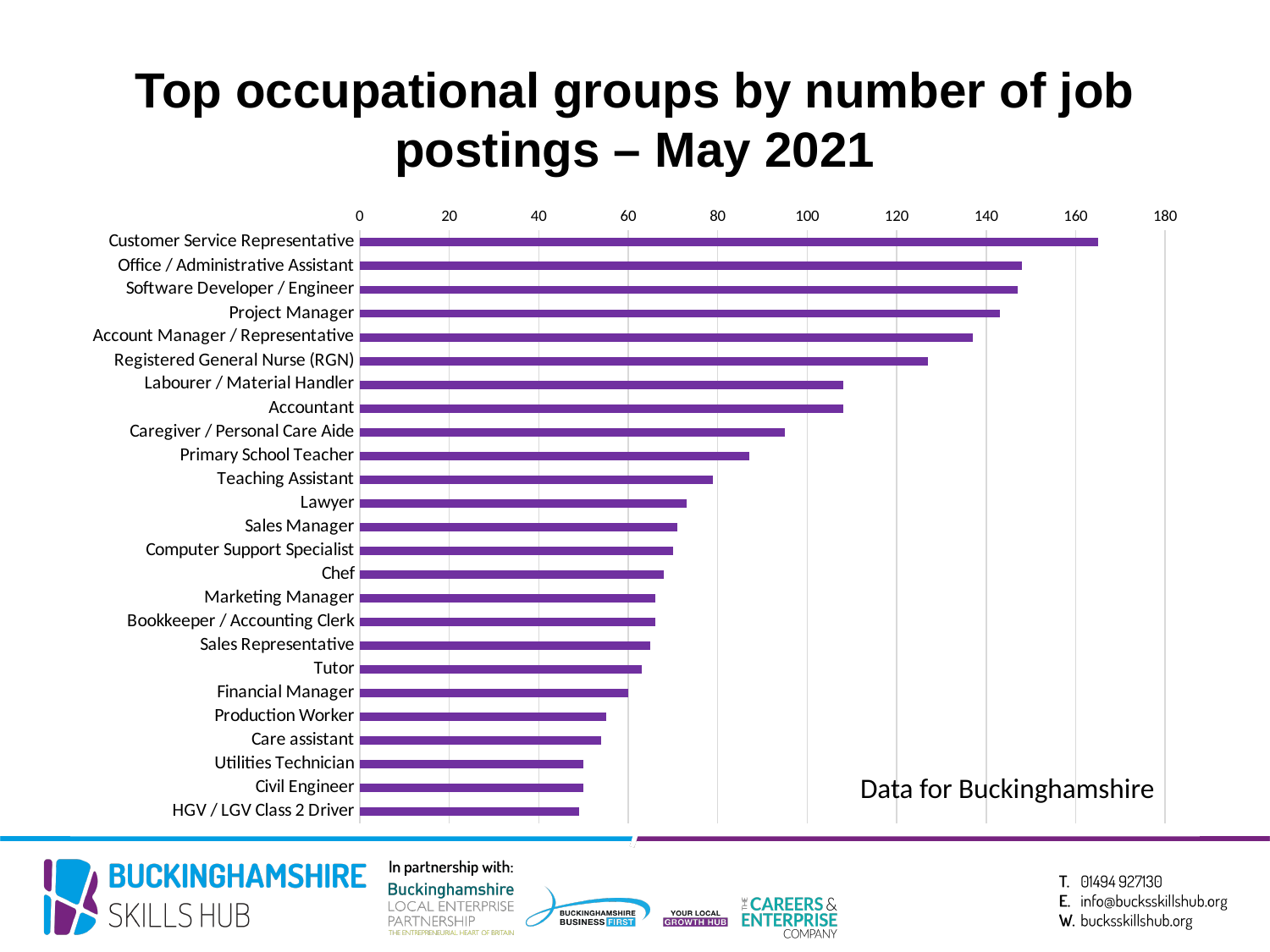
Which has more job postings, Project Manager or Primary School Teacher? Project Manager Is the value for Registered General Nurse (RGN) greater or less than 120? greater Is the value for Customer Service Representative greater or less than 160? greater Which occupational group has the highest number of job postings? Customer Service Representative Which has more job postings, Lawyer or Tutor? Lawyer Is the value for Production Worker greater or less than 60? less What is the title of the chart on the slide? Top occupational groups by number of job postings – May 2021 How many occupational groups are plotted in the chart? 25 Which occupational group has the lowest number of job postings? HGV / LGV Class 2 Driver What kind of chart is shown on the slide? bar chart